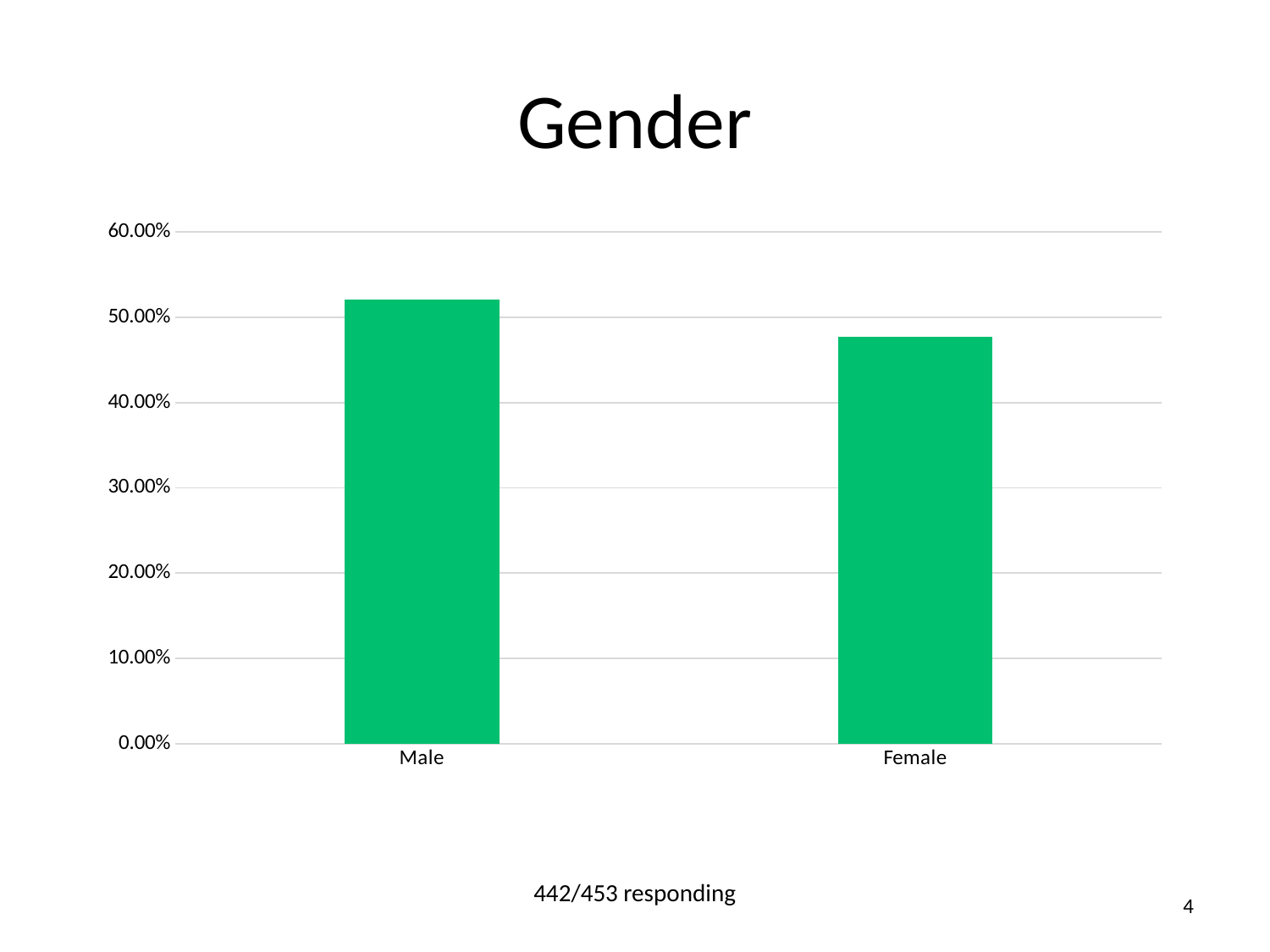
Is the value for Female greater or less than 40.00%? greater Which category has the lowest value? Female Which category has the highest value? Male Is the value for Male greater or less than 50.00%? greater Is the value for Female greater or less than 50.00%? less What kind of chart is shown on the slide? bar chart Which is larger, the value for Male or the value for Female? Male How many categories are shown on the x axis? 2 What is the highest value shown on the y axis? 60.00% What is the title of the chart? Gender